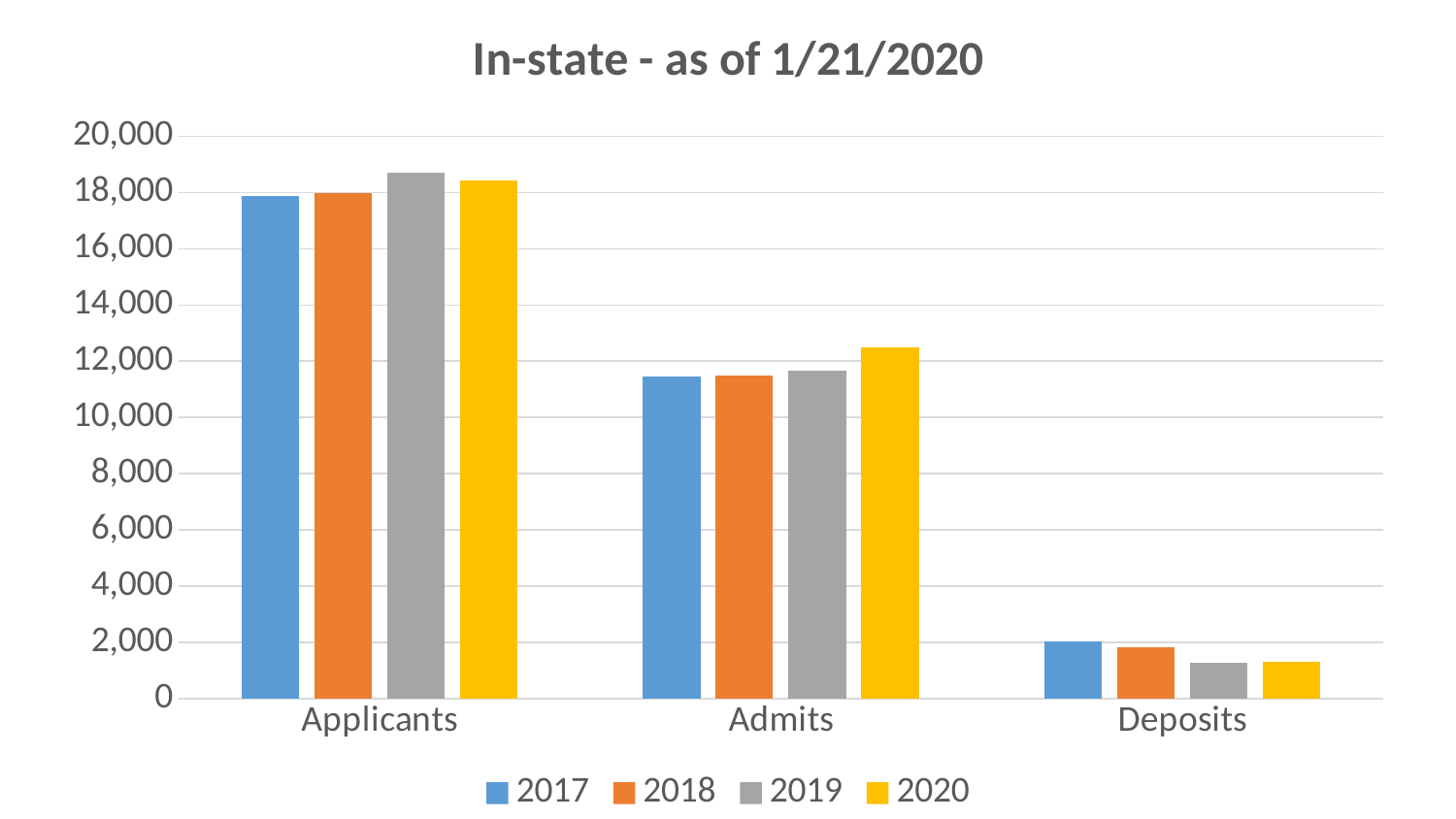
What kind of chart is shown on the slide? Bar chart How many categories are shown on the x axis? 3 Is the value for Deposits in 2019 greater or less than 2,000? less For Deposits, which is larger: the 2018 value or the 2019 value? 2018 Which year has the highest value for Deposits? 2017 Which year has the highest value for Applicants? 2019 Is the value for Admits in 2020 greater or less than 12,000? greater How many series does the legend list? 4 Which category has the lowest values overall? Deposits What is the title of the chart? In-state - as of 1/21/2020 Which year has the highest value for Admits? 2020 Is the value for Applicants in 2019 greater or less than 18,000? greater